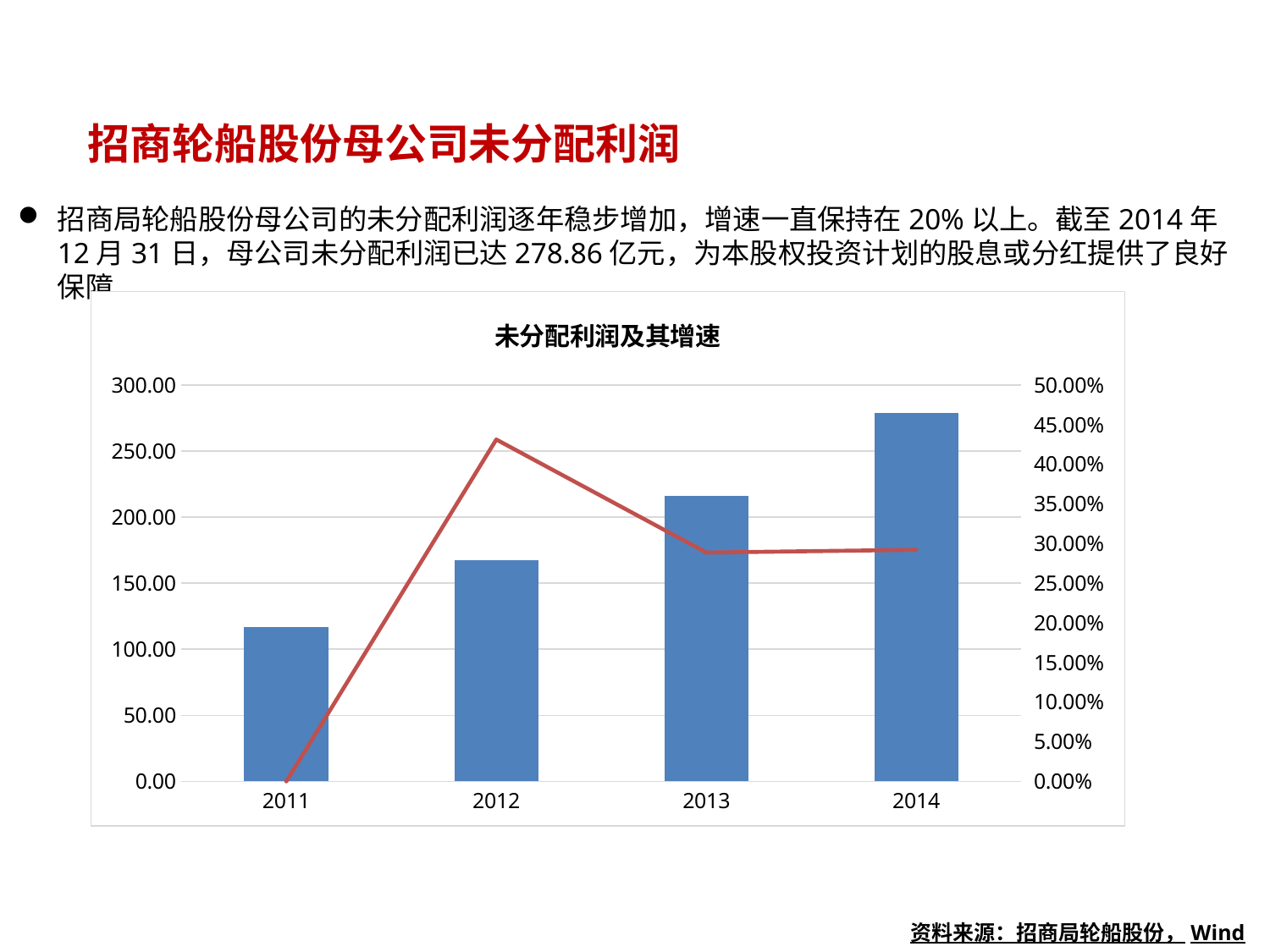
Which year has the highest point on the red line (growth rate)? 2012 Is the bar value for 2013 greater or less than 200.00? greater Which bar is taller, 2012 or 2013? 2013 Is the bar value for 2011 greater or less than 150.00? less Is the growth rate (red line) for 2012 greater or less than 40.00%? greater Which year has the tallest bar in the chart? 2014 Do the bar values rise or fall from 2011 to 2014? Rise What kind of chart is shown on the slide? A bar chart combined with a line What is the title of the chart? 未分配利润及其增速 How many years are shown on the x axis of the chart? 4 Which year has the shortest bar in the chart? 2011